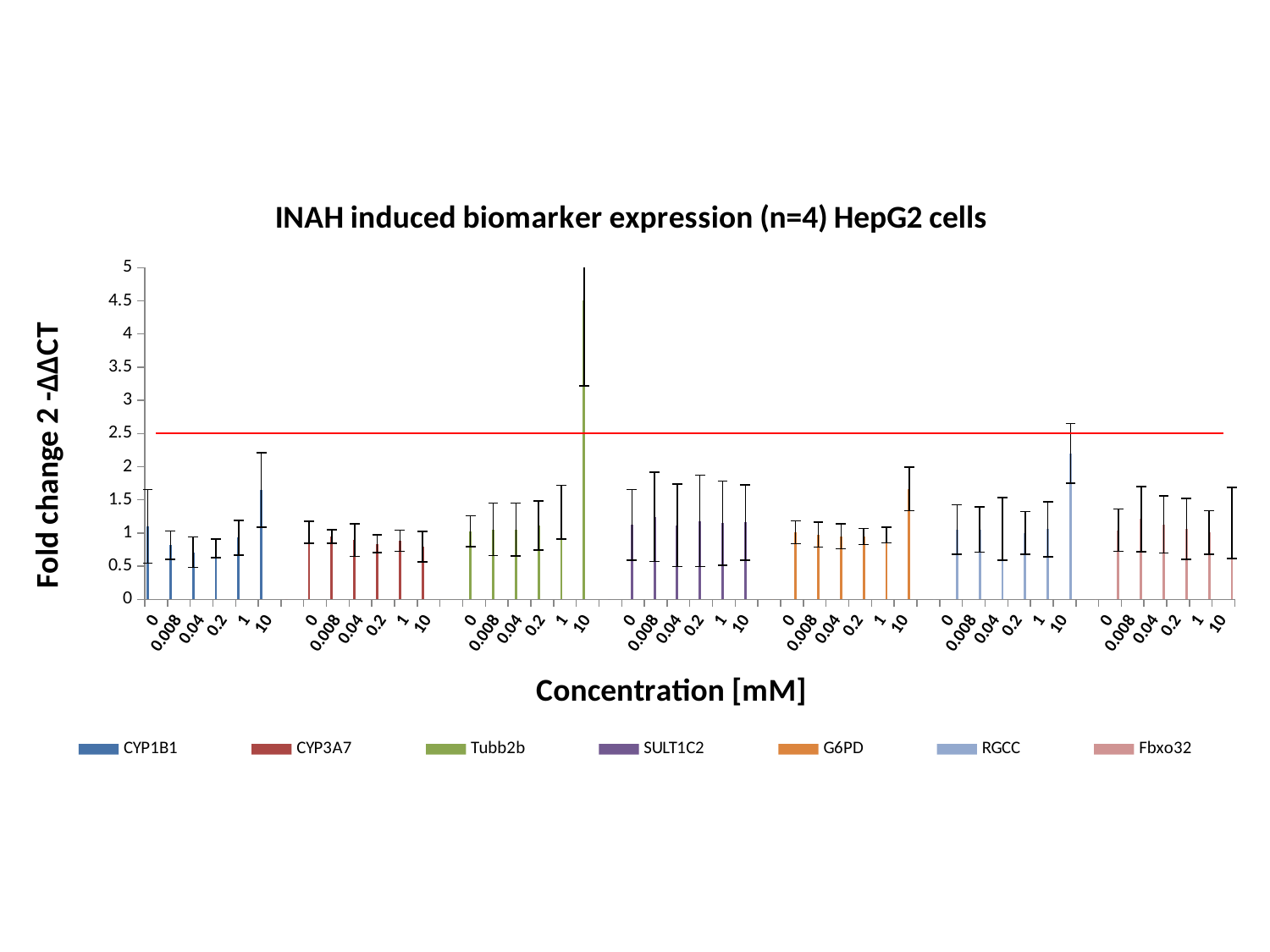
Is the value for CYP1B1 at 10 mM greater or less than 1? greater Is the value for G6PD at 10 mM greater or less than 2? less Is the value for RGCC at 10 mM greater or less than 2.5? less How many series does the legend list? 7 Which is larger: the value for CYP1B1 at 10 mM or the value for CYP1B1 at 0.04 mM? CYP1B1 at 10 mM What is the label of the x axis? Concentration [mM] How many concentration levels are plotted for each biomarker series? 6 What kind of chart is shown on the slide? Bar chart Which is larger: the value for Tubb2b at 10 mM or the value for RGCC at 10 mM? Tubb2b at 10 mM What is the title of the chart? INAH induced biomarker expression (n=4) HepG2 cells Which series has the tallest bar in the chart? Tubb2b